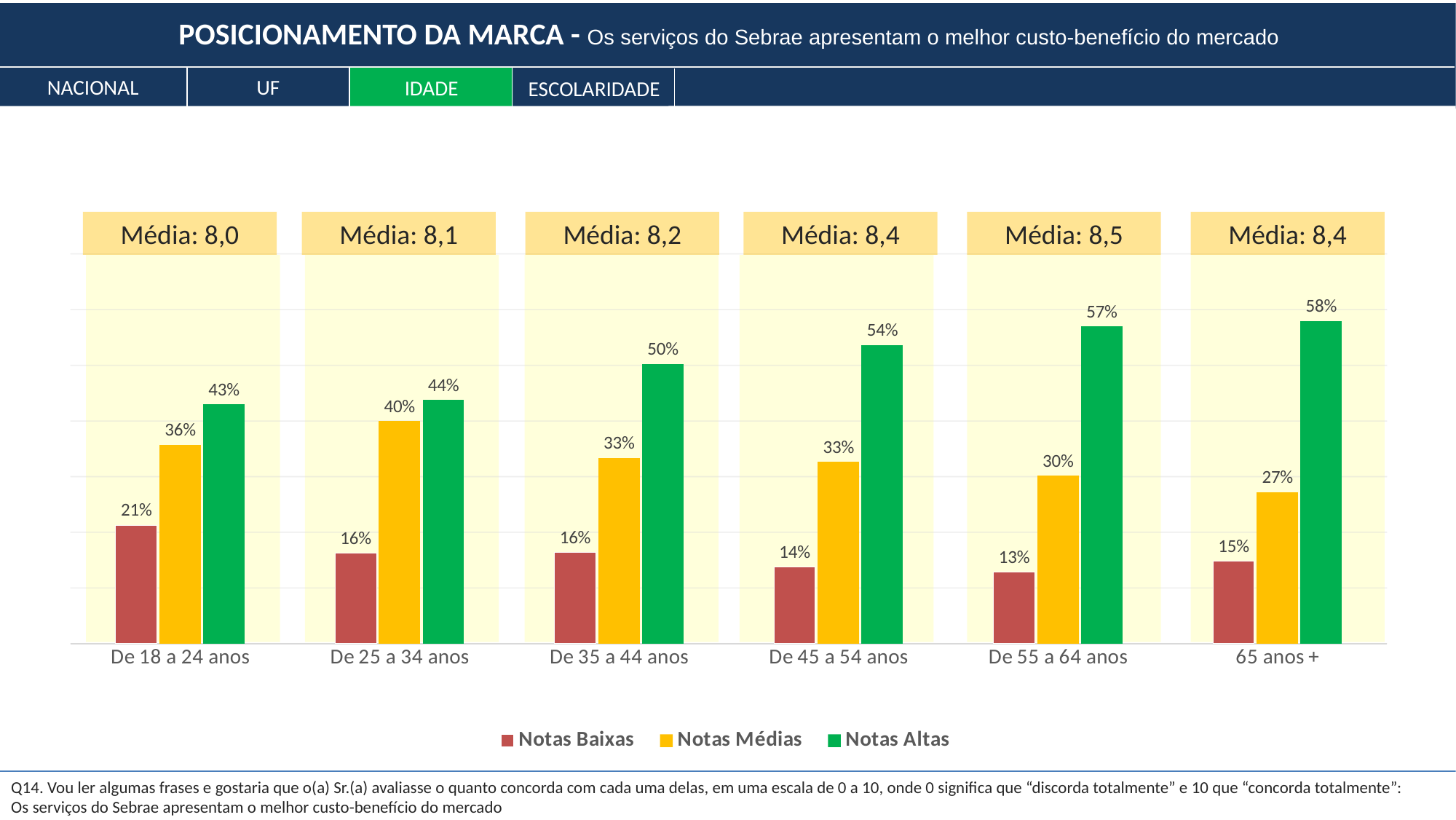
What is the value of Notas Médias for the '65 anos +' age group? 27% What is the difference between Notas Altas and Notas Baixas for the 'De 55 a 64 anos' age group? 44 percentage points Which age group has the lowest Notas Baixas value? De 55 a 64 anos How many series does the legend list? 3 Do the Notas Altas values rise or fall from 'De 18 a 24 anos' to '65 anos +'? Rise What is the value of Notas Altas for the 'De 35 a 44 anos' age group? 50% What is the value of Notas Baixas for the 'De 18 a 24 anos' age group? 21% How many age groups are shown on the x axis? 6 What kind of chart is shown on the slide? Bar chart Which age group has the highest Notas Altas value? 65 anos + What is the Média shown above the 'De 55 a 64 anos' age group? 8,5 Which is larger for the 'De 25 a 34 anos' group: Notas Médias or Notas Altas? Notas Altas